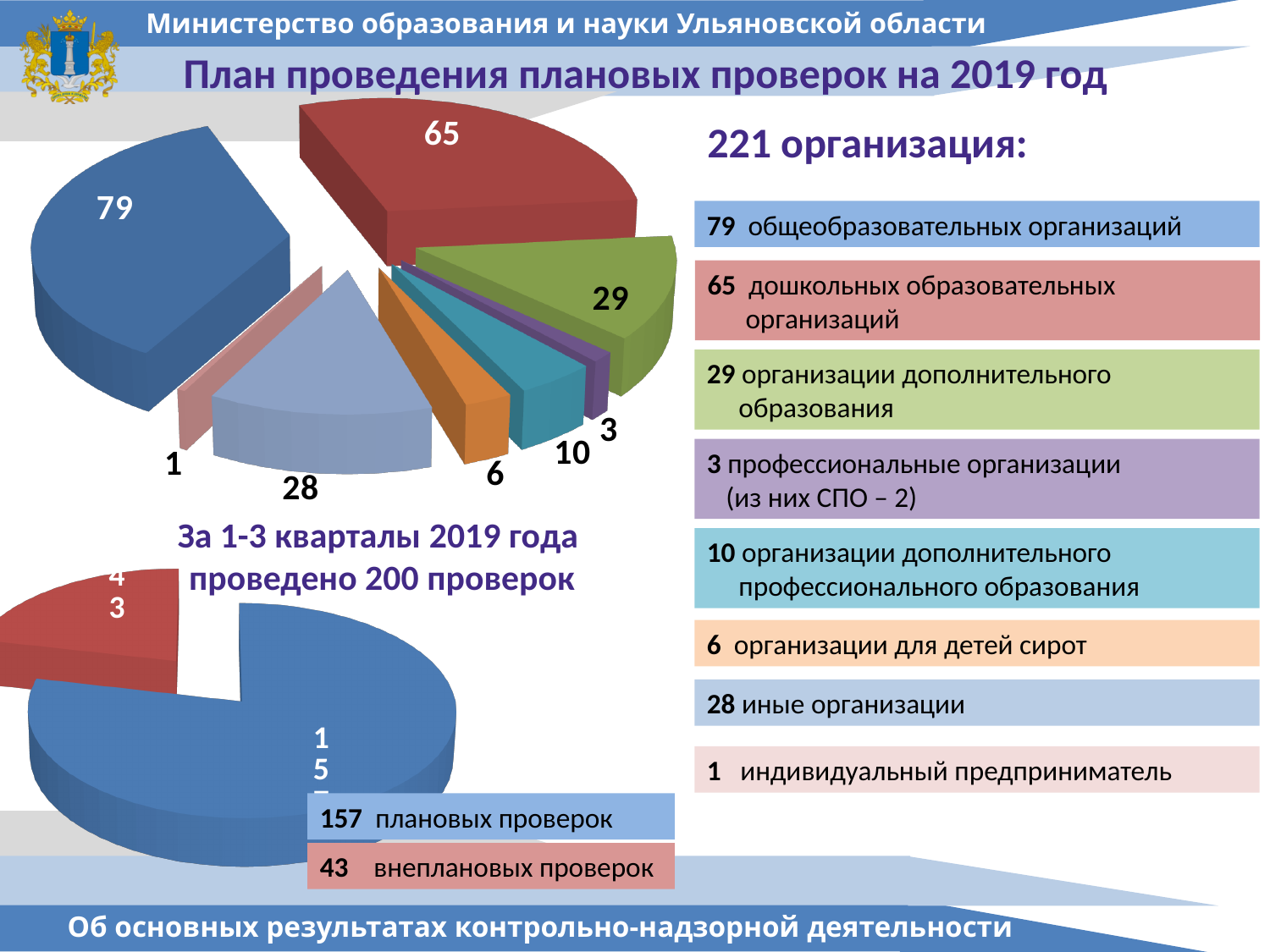
In the top pie chart, what value is shown for дошкольные образовательные организации? 65 In the bottom pie chart, what is the difference between плановые проверки and внеплановые проверки? 114 In the top pie chart, which category has the smallest slice? индивидуальный предприниматель How many slices does the top pie chart have? 8 In the top pie chart, which is larger: организации дополнительного образования or иные организации? организации дополнительного образования In the top pie chart, what value is shown for организации дополнительного образования? 29 In the bottom pie chart, what value is shown for внеплановые проверки? 43 In the top pie chart, which category has the largest slice? общеобразовательные организации What type of chart is the bottom chart on the slide? pie chart In the top pie chart, what value is shown for общеобразовательные организации? 79 What is the total of all slices in the top pie chart? 221 In the top pie chart, what is the difference between the values for общеобразовательные организации and дошкольные образовательные организации? 14